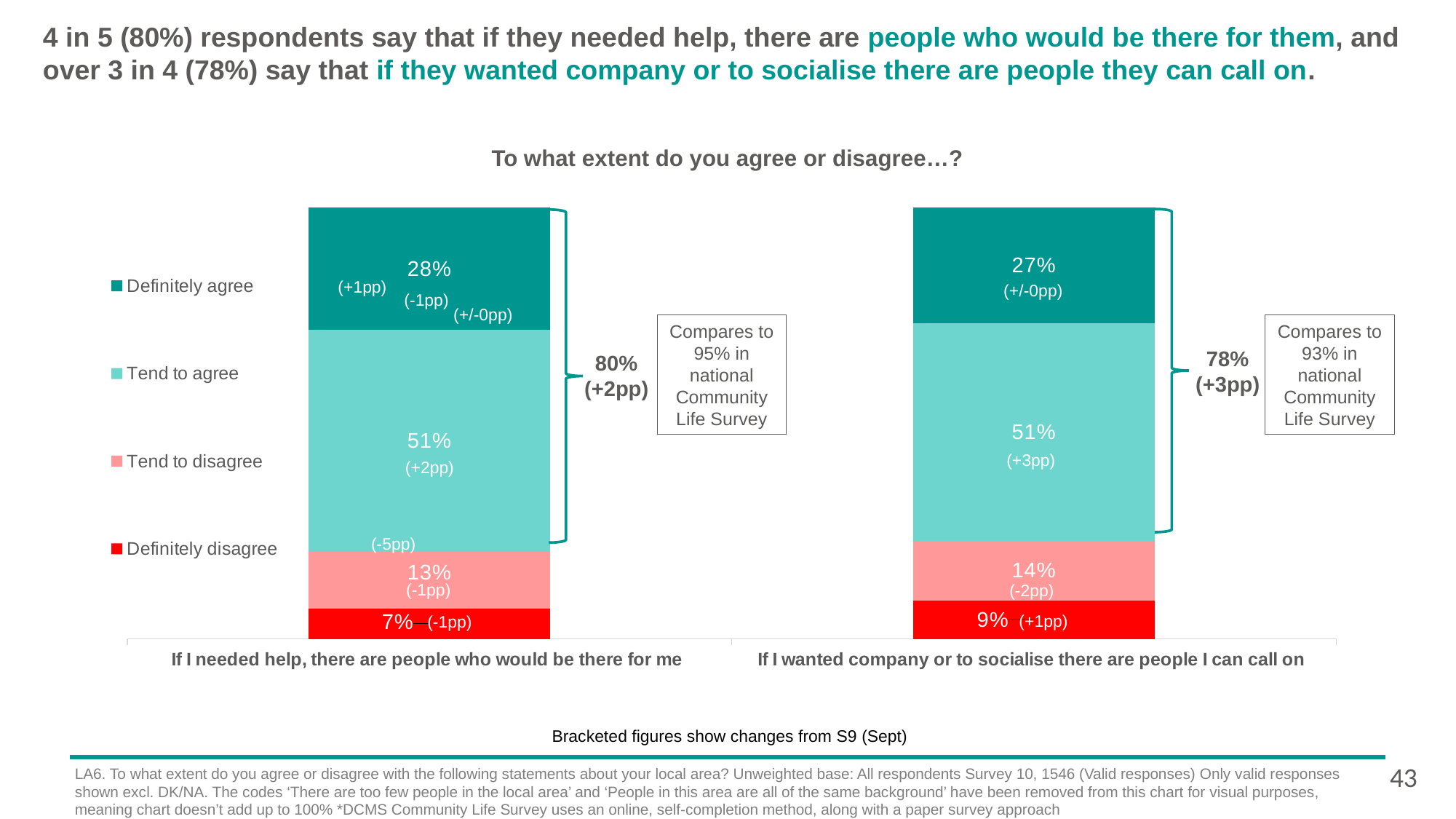
Which response category is the largest segment for 'If I wanted company or to socialise there are people I can call on'? Tend to agree What percentage 'Definitely disagree' with 'If I needed help, there are people who would be there for me'? 7% What kind of chart is shown on the slide? Stacked bar chart How many statements (categories) are plotted on the chart? 2 What is the difference in the 'Definitely disagree' percentage between the two statements? 2 percentage points Which statement has the higher 'Definitely agree' percentage? If I needed help, there are people who would be there for me What is the combined agree percentage shown for 'If I wanted company or to socialise there are people I can call on'? 78% What percentage 'Tend to disagree' with 'If I wanted company or to socialise there are people I can call on'? 14% What is the title of the chart? To what extent do you agree or disagree…? Which response category is the smallest segment for 'If I needed help, there are people who would be there for me'? Definitely disagree How many series does the legend list? 4 What percentage 'Definitely agree' with 'If I needed help, there are people who would be there for me'? 28%